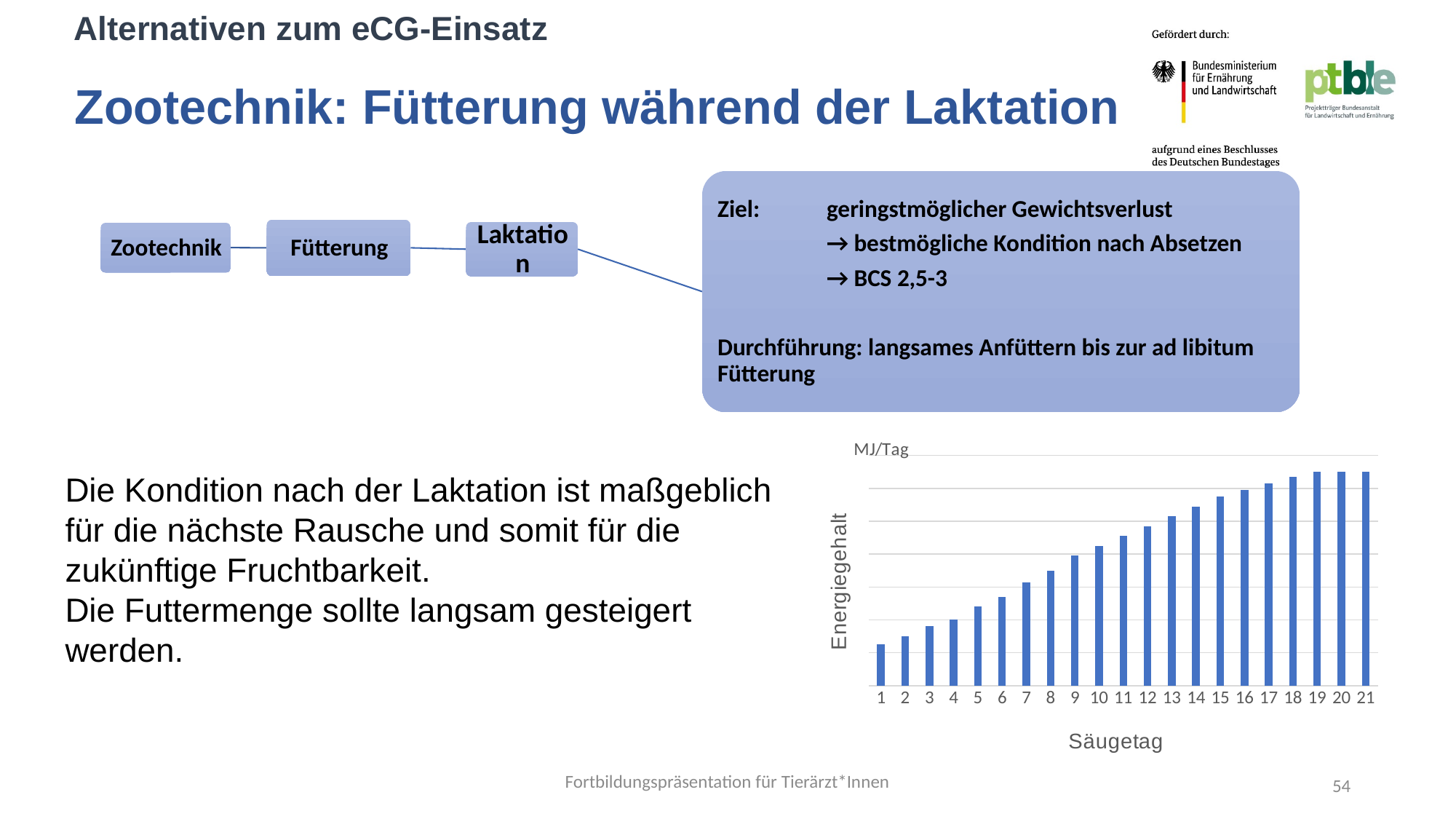
What is the title of the x axis of the chart? Säugetag What unit is shown above the y axis of the chart? MJ/Tag Which is larger in the chart, the value for Säugetag 10 or the value for Säugetag 3? Säugetag 10 What kind of chart is shown on the slide? bar chart Which is larger in the chart, the value for Säugetag 5 or the value for Säugetag 15? Säugetag 15 Which Säugetag has the lowest value in the chart? 1 Which is larger in the chart, the value for Säugetag 1 or the value for Säugetag 21? Säugetag 21 How many Säugetag categories are plotted on the x axis of the chart? 21 Do the values in the chart rise or fall as the Säugetag increases from 1 to 21? rise